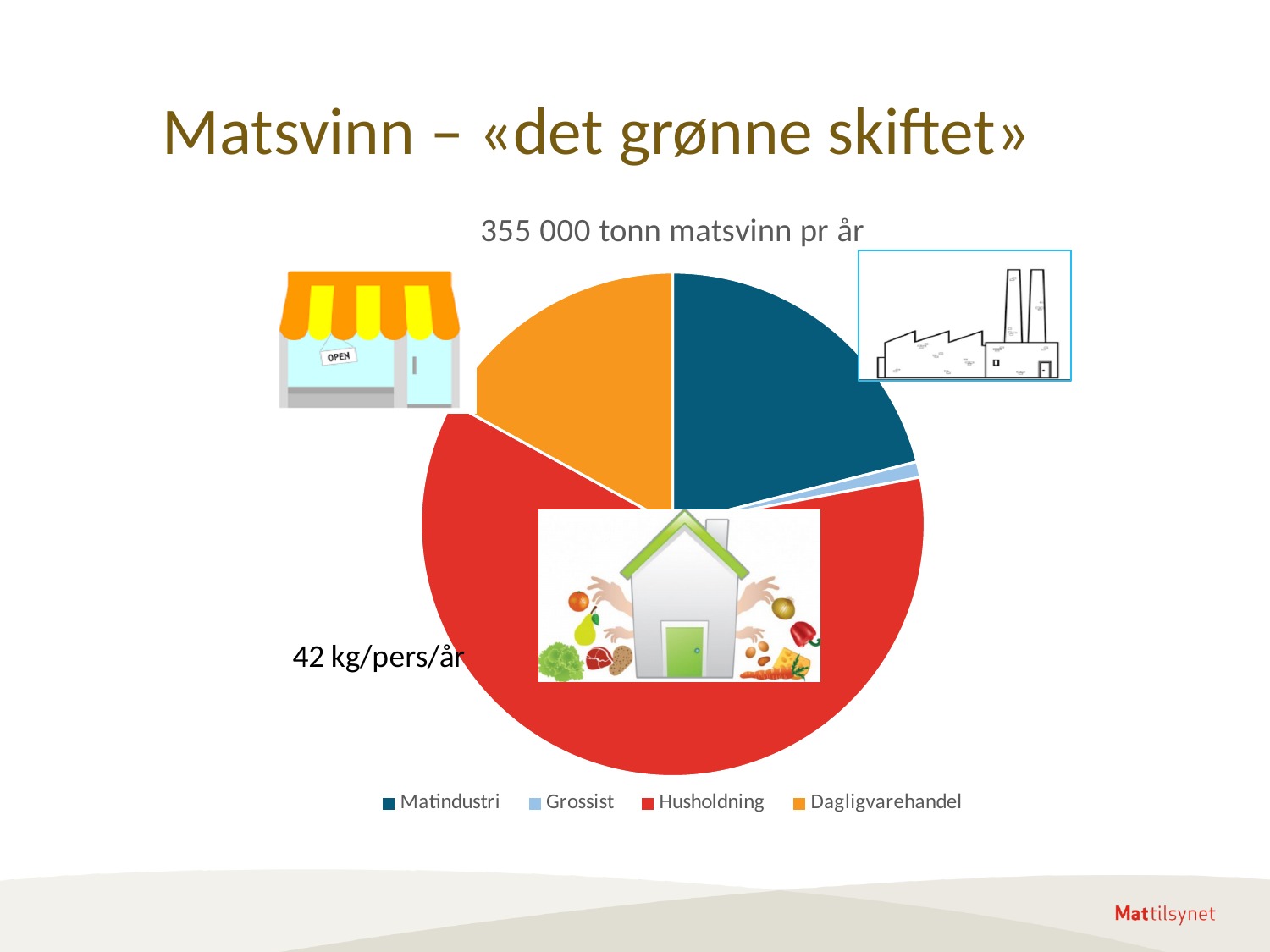
Which slice is larger in the pie chart, Matindustri or Dagligvarehandel? Matindustri How many entries does the legend of the pie chart list? 4 Which slice is larger in the pie chart, Husholdning or Matindustri? Husholdning Which category has the smallest slice in the pie chart? Grossist Which category is shown in red in the pie chart? Husholdning How many slices does the pie chart have? 4 What is the title of the pie chart? 355 000 tonn matsvinn pr år Which slice is larger in the pie chart, Grossist or Dagligvarehandel? Dagligvarehandel Which category has the largest slice in the pie chart? Husholdning What kind of chart is shown on the slide? pie chart